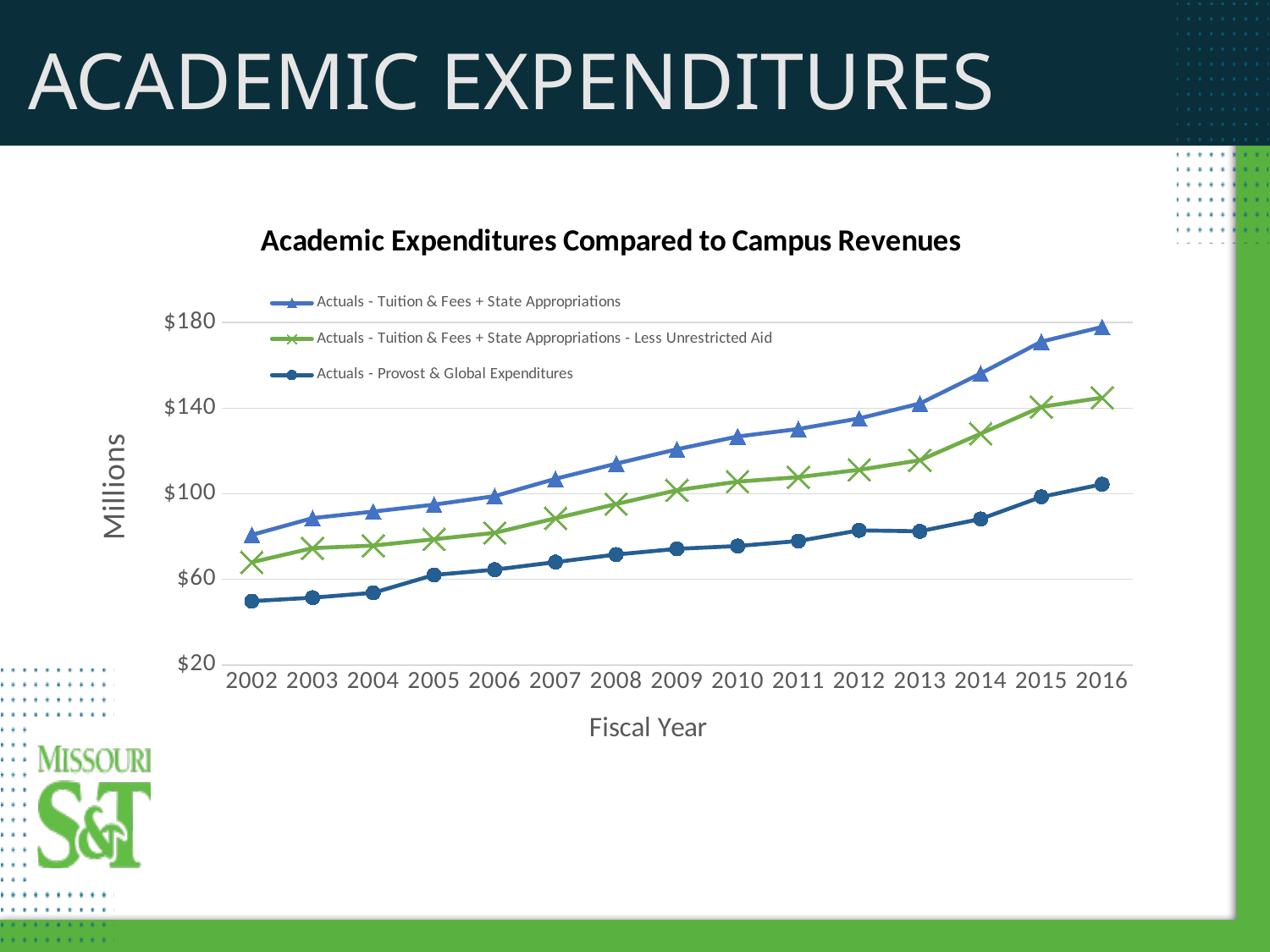
How many fiscal years are plotted along the x axis? 15 What is the label of the vertical axis? Millions What is the title of the chart? Academic Expenditures Compared to Campus Revenues In 2010, which is larger: Actuals - Tuition & Fees + State Appropriations or Actuals - Provost & Global Expenditures? Actuals - Tuition & Fees + State Appropriations Is the value for Actuals - Provost & Global Expenditures in 2013 greater or less than $100? less What kind of chart is shown on the slide? Line chart Do the values for Actuals - Tuition & Fees + State Appropriations generally rise or fall from 2002 to 2016? Rise Is the value for Actuals - Provost & Global Expenditures in 2002 greater or less than $60? less Is the value for Actuals - Tuition & Fees + State Appropriations in 2015 greater or less than $140? greater How many series does the legend list? 3 Which series has the lowest values across all fiscal years? Actuals - Provost & Global Expenditures